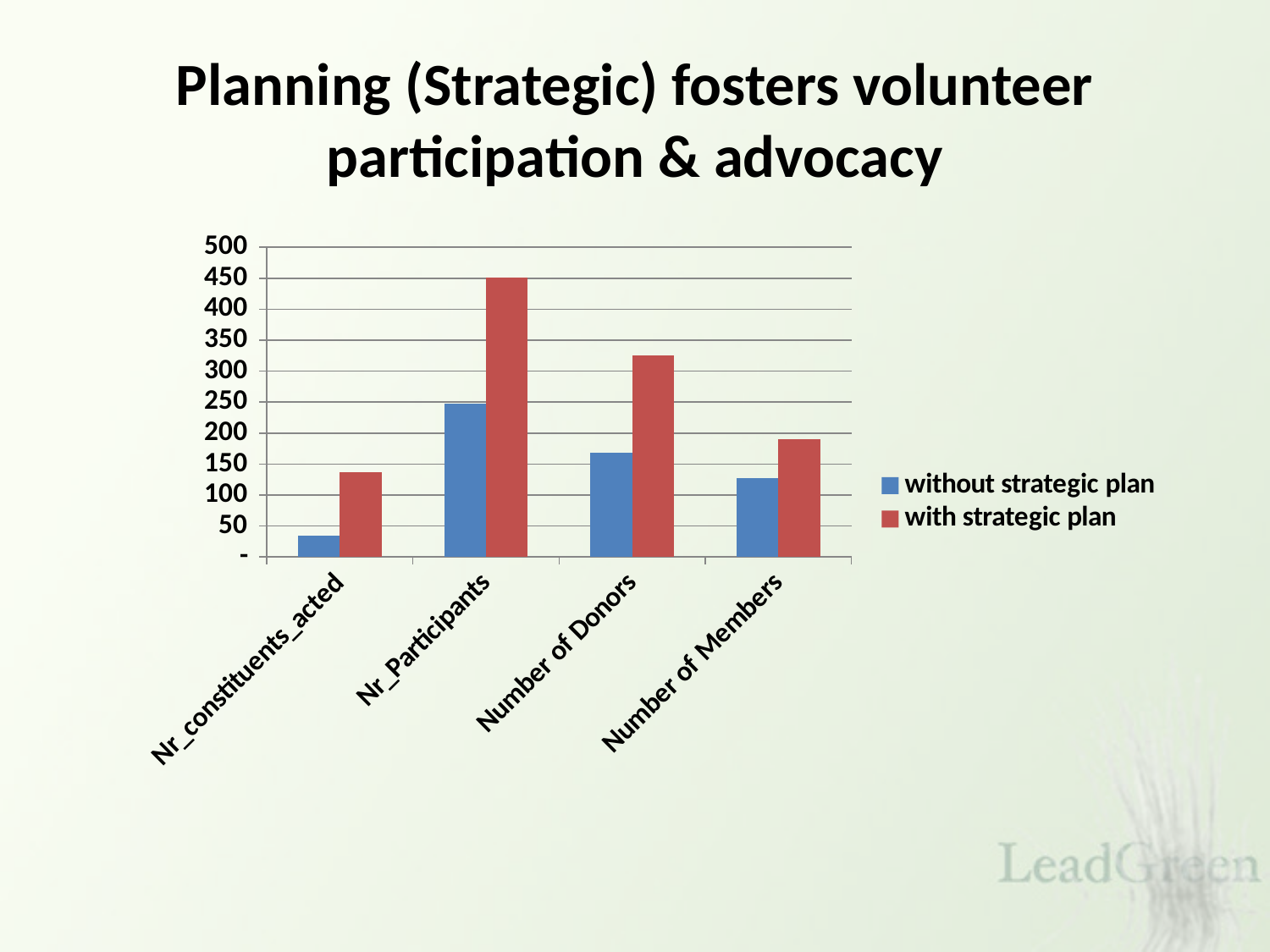
Which colour represents the 'with strategic plan' series? red Which category has the highest value for the 'with strategic plan' series? Nr_Participants Is the 'without strategic plan' value for Nr_constituents_acted greater or less than 50? less What kind of chart is shown on the slide? bar chart Is the 'with strategic plan' value for Nr_Participants greater or less than 400? greater Which category has the lowest value for the 'with strategic plan' series? Nr_constituents_acted Which category has the lowest value for the 'without strategic plan' series? Nr_constituents_acted How many categories are shown on the x axis? 4 Is the 'with strategic plan' value for Number of Donors greater or less than 300? greater How many series does the legend list? 2 For Number of Donors, which series has the larger value: 'without strategic plan' or 'with strategic plan'? with strategic plan